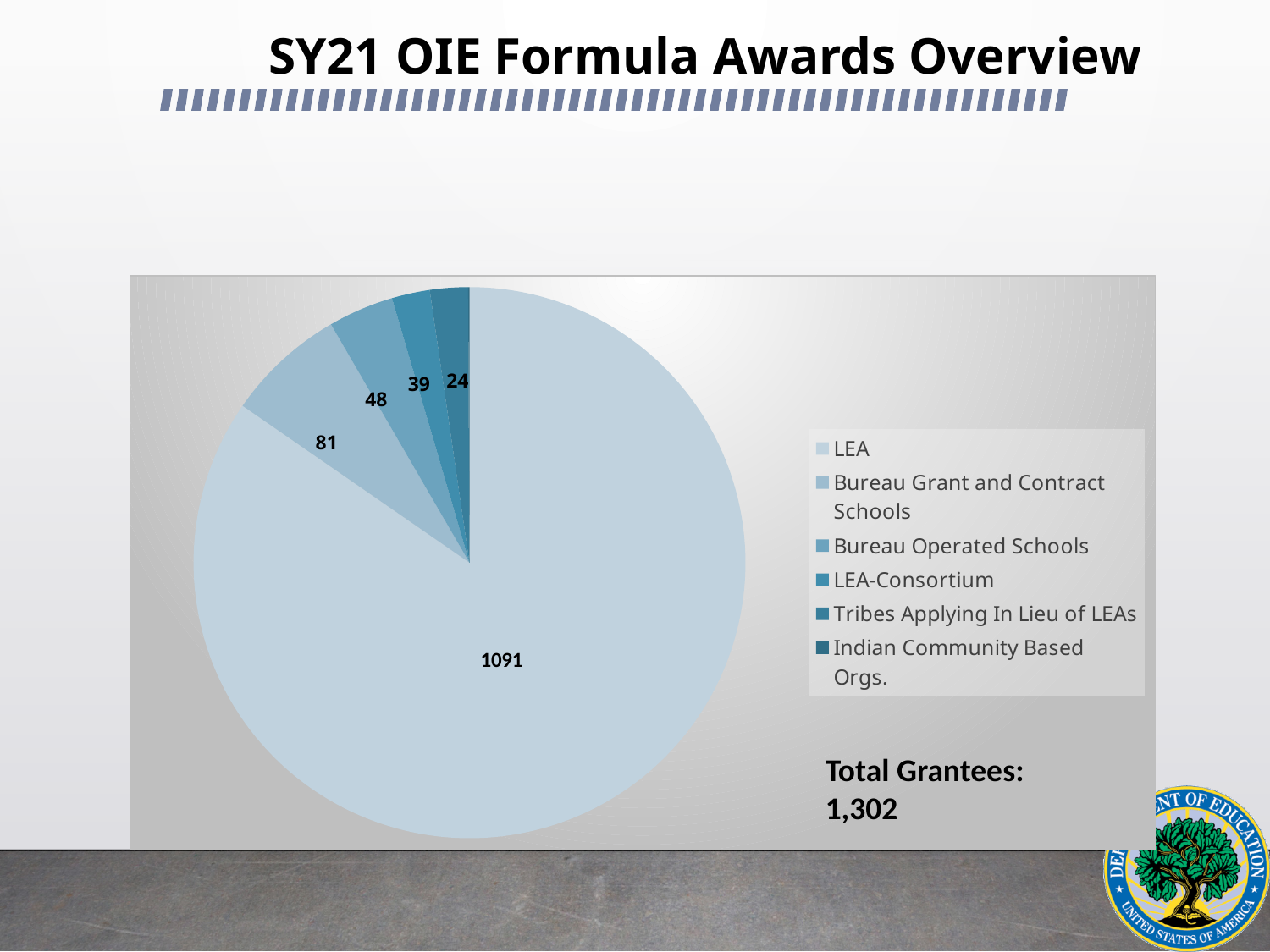
What is the value for Bureau Grant and Contract Schools? 81 How many categories does the legend list? 6 What is the value for Tribes Applying In Lieu of LEAs? 24 Which category has the largest slice of the pie? LEA What kind of chart is shown on the slide? pie chart What is the difference between the LEA value and the Bureau Grant and Contract Schools value? 1010 What is the value for Bureau Operated Schools? 48 What is the difference between the Bureau Operated Schools value and the LEA-Consortium value? 9 What total number of grantees is stated on the slide? 1,302 Which is larger, Bureau Operated Schools or LEA-Consortium? Bureau Operated Schools What is the value for LEA in the pie chart? 1091 What is the value for LEA-Consortium? 39